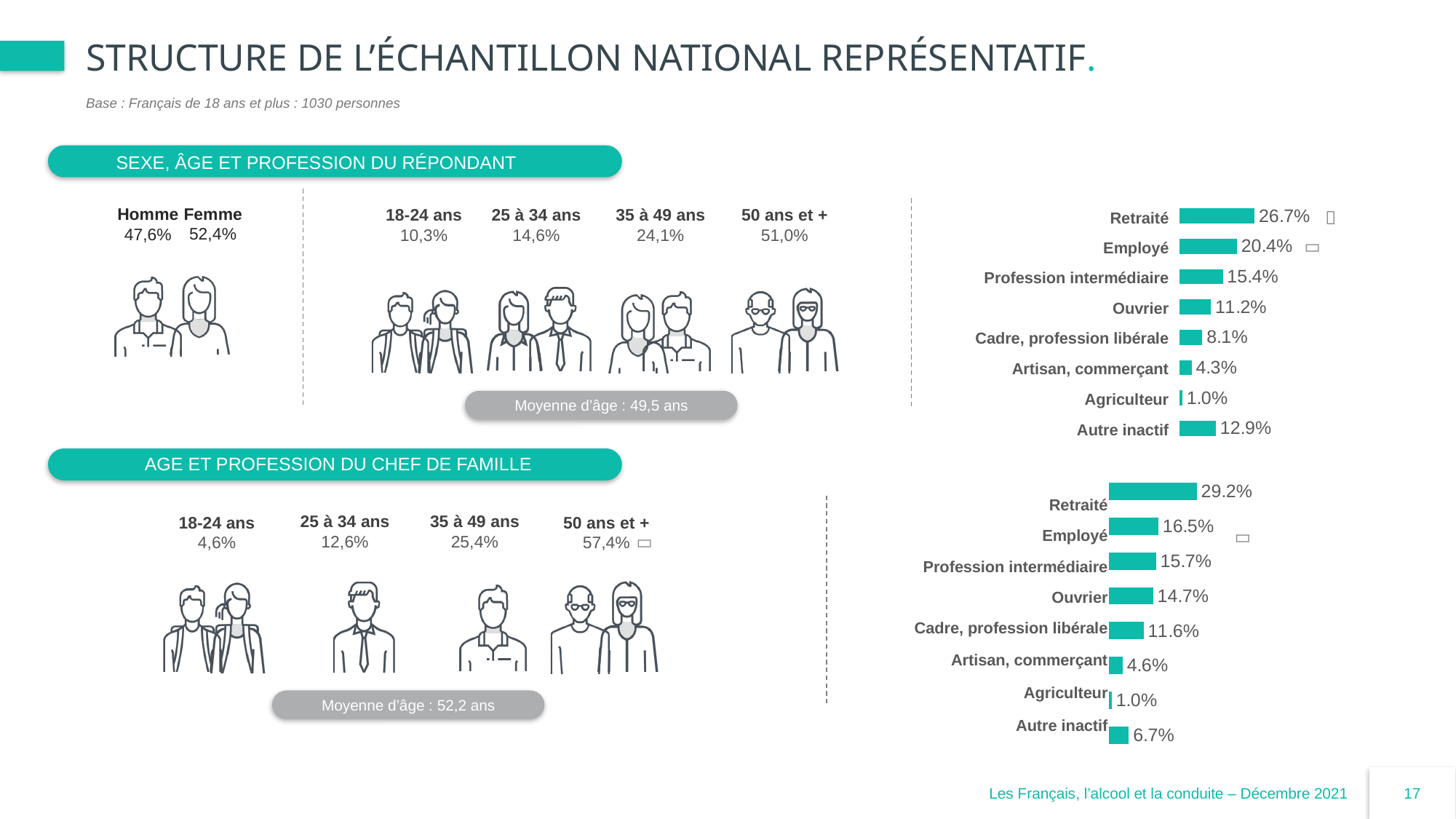
In the upper right bar chart (profession du répondant), what is the value for Employé? 20.4% In the lower right bar chart (profession du chef de famille), what is the value for Autre inactif? 6.7% In the upper right bar chart (profession du répondant), which category has the lowest value? Agriculteur In the upper right bar chart (profession du répondant), how many categories are shown? 8 In the upper right bar chart (profession du répondant), what is the difference between Retraité and Employé? 6.3% In the lower right bar chart (profession du chef de famille), what is the difference between Retraité and Employé? 12.7% In the lower right bar chart (profession du chef de famille), which is larger: Ouvrier or Autre inactif? Ouvrier In the upper right bar chart (profession du répondant), which is larger: Ouvrier or Autre inactif? Autre inactif In the upper right bar chart (profession du répondant), which category has the highest value? Retraité What type of chart is the upper right chart (profession du répondant)? Bar chart In the lower right bar chart (profession du chef de famille), what is the value for Cadre, profession libérale? 11.6% In the lower right bar chart (profession du chef de famille), which category has the highest value? Retraité